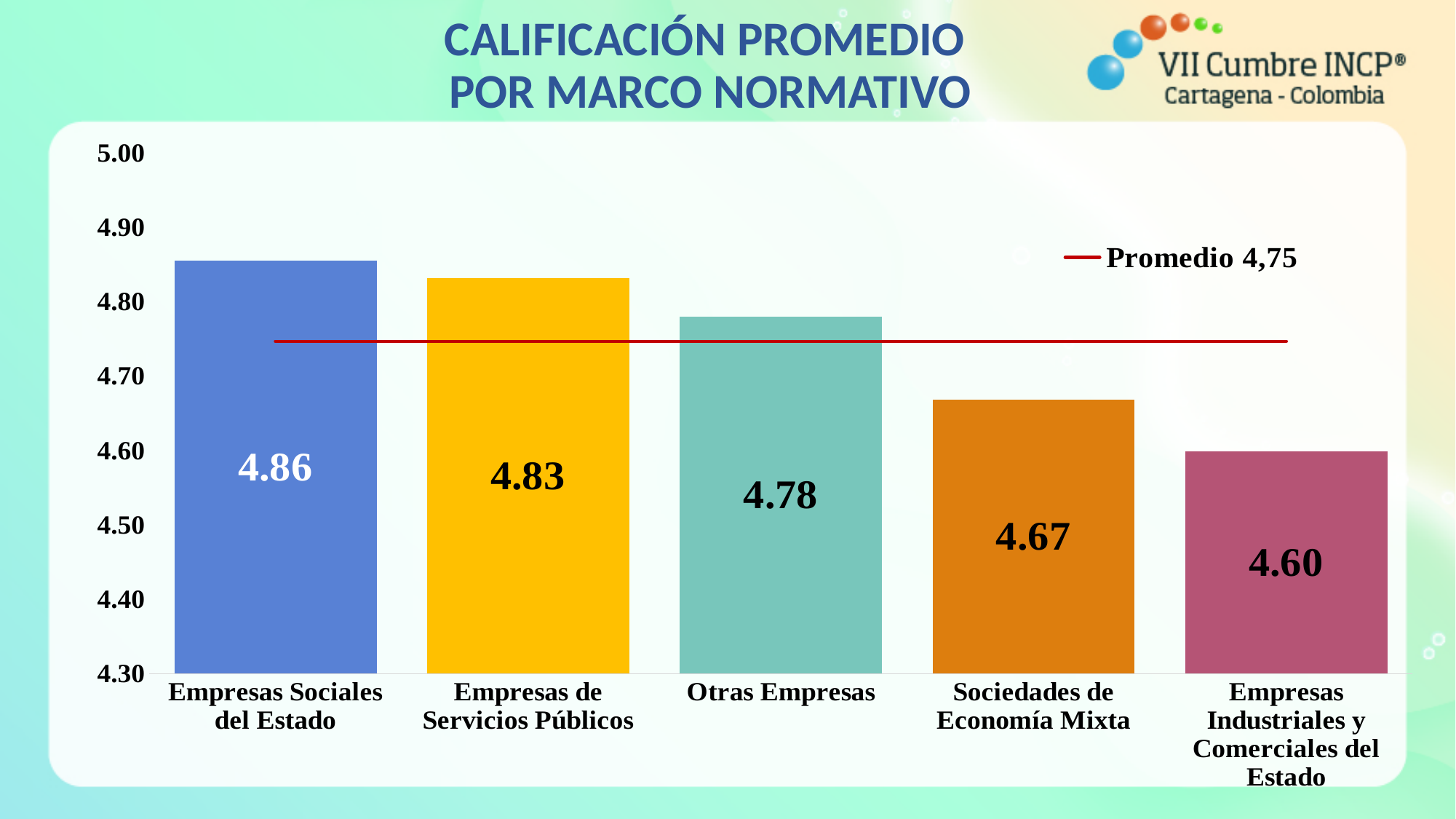
What average value does the red horizontal line (Promedio) represent? 4,75 What is the value for Sociedades de Economía Mixta? 4.67 What is the difference between the values for Empresas Sociales del Estado and Empresas Industriales y Comerciales del Estado? 0.26 Which is larger, the value for Empresas de Servicios Públicos or the value for Sociedades de Economía Mixta? Empresas de Servicios Públicos Is the value for Empresas Industriales y Comerciales del Estado greater or less than 4.70? less What is the value for Empresas Sociales del Estado? 4.86 What kind of chart is shown on the slide? bar chart How many categories are shown in the chart? 5 Do the values rise or fall from left to right across the categories? fall Which category has the lowest value? Empresas Industriales y Comerciales del Estado What is the value for Otras Empresas? 4.78 Which category has the highest value? Empresas Sociales del Estado